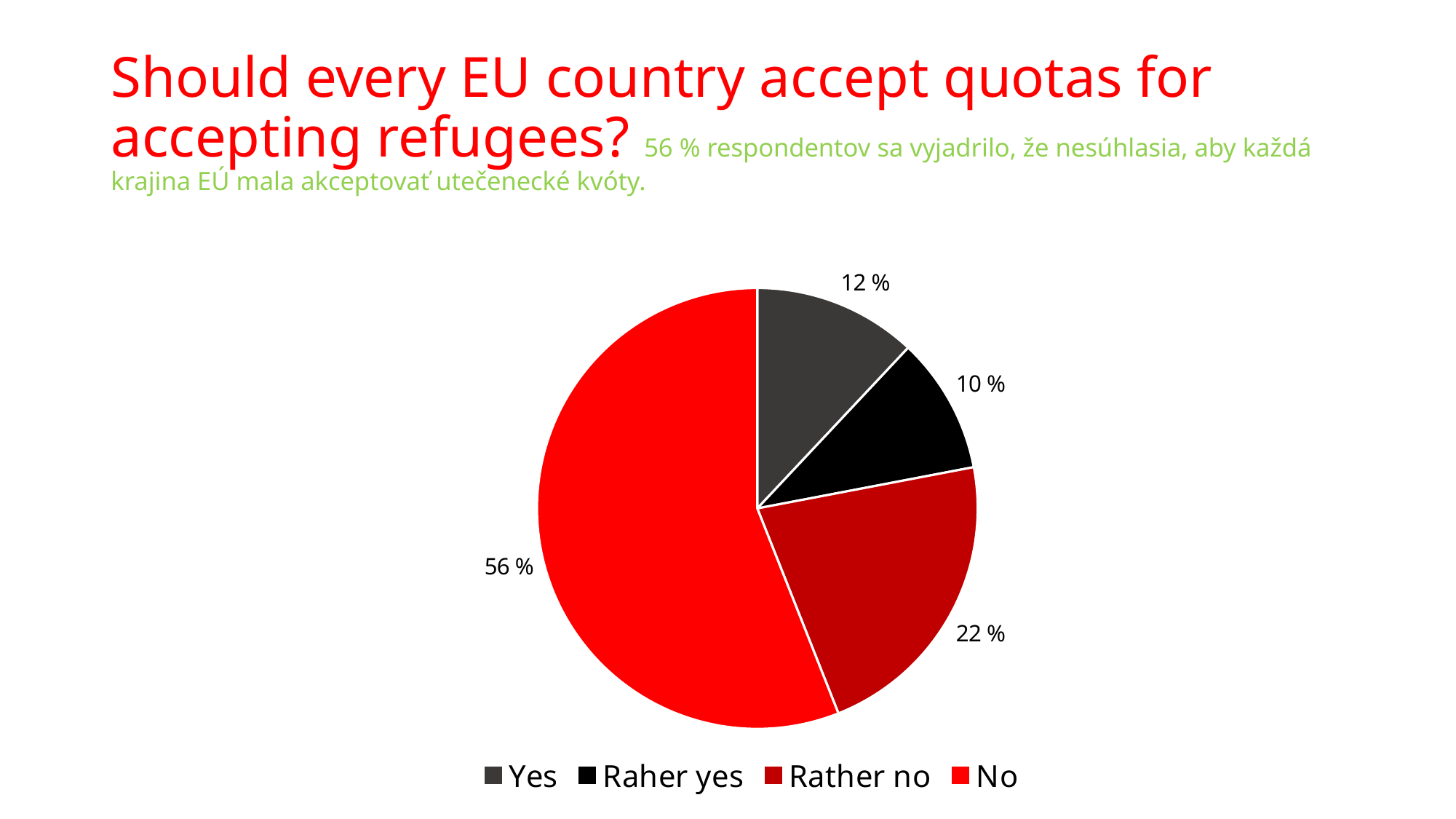
What colour is the "No" slice? red What share of respondents answered "Yes"? 12 % Which answer has the smallest slice of the pie? Raher yes How many slices does the pie chart have? 4 What kind of chart is shown on the slide? pie chart What is the difference in percentage points between "No" and "Rather no"? 34 What share of respondents answered "Rather no"? 22 % What share of respondents answered "No"? 56 % What share of respondents answered "Raher yes"? 10 % Which is larger, the share for "Yes" or the share for "Rather no"? Rather no Which answer has the largest slice of the pie? No How many entries does the legend list? 4